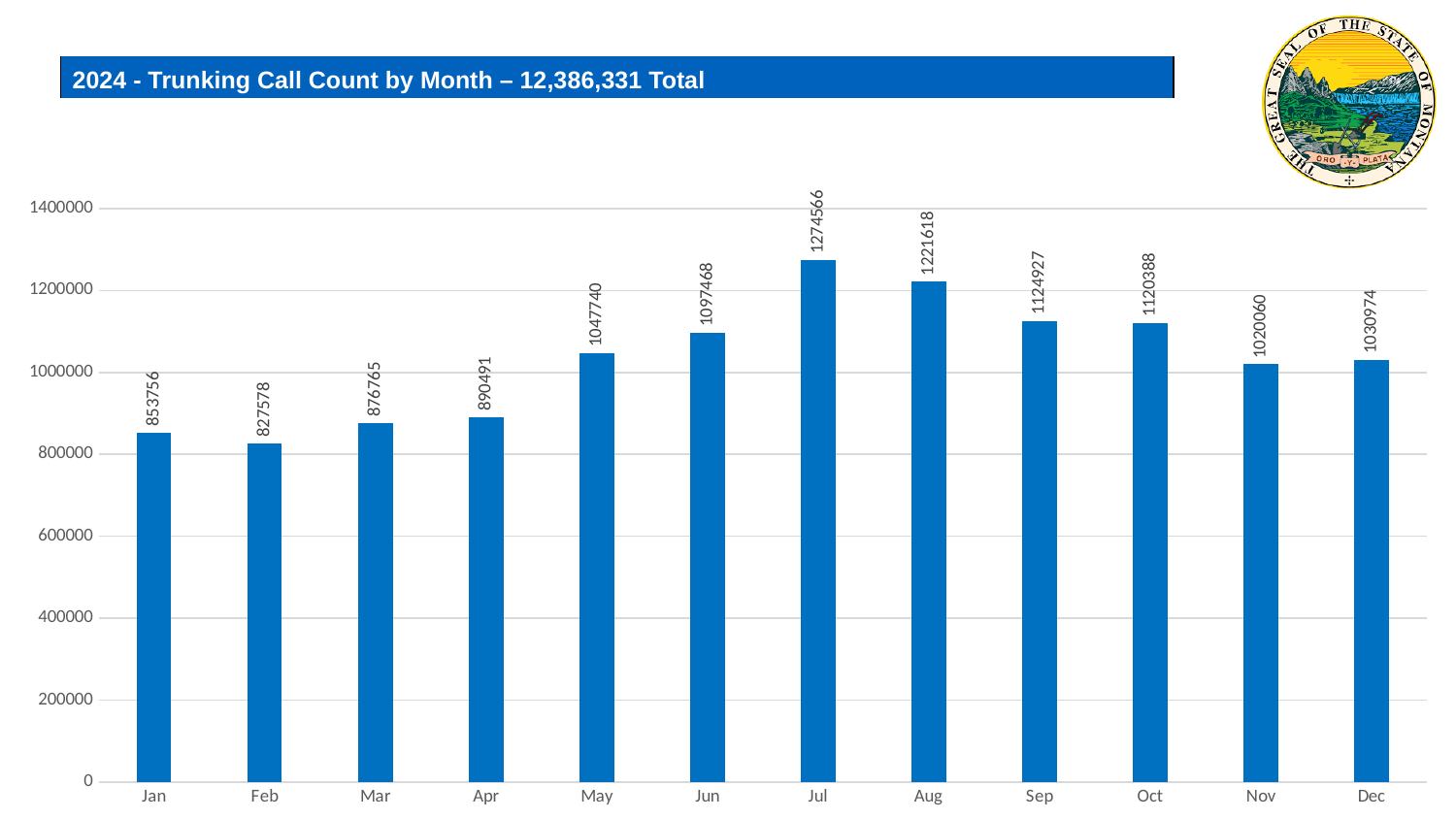
What kind of chart is shown on the slide? Bar chart Which month has a larger call count, May or June? Jun Is the value for April greater or less than 1000000? less How many months are shown on the x axis? 12 What is the difference between the January and February call counts? 26178 Which month has the highest trunking call count? Jul What is the trunking call count for July? 1274566 What is the difference between the July and August call counts? 52948 What is the trunking call count for November? 1020060 What total is stated in the chart title? 12,386,331 What is the trunking call count for February? 827578 Which month has the lowest trunking call count? Feb